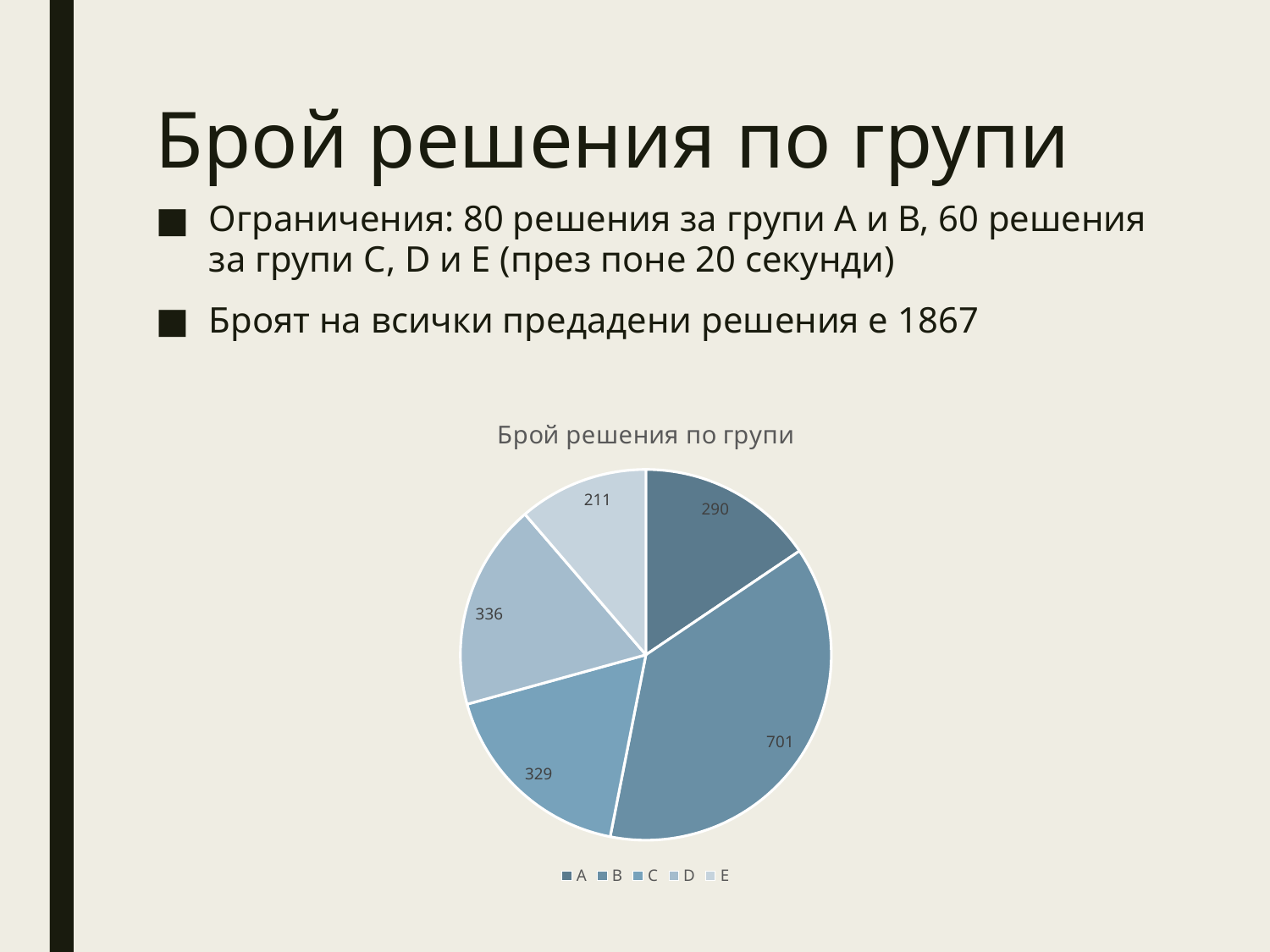
What is the value for group D in the pie chart? 336 What is the difference between the values for group B and group A? 411 What type of chart is shown on the slide? pie chart What is the title of the pie chart? Брой решения по групи Which is larger, the value for group C or group D? D Which group has the smallest slice in the pie chart? E What is the value for group B in the pie chart? 701 What is the value for group E in the pie chart? 211 Which group has the largest slice in the pie chart? B What is the value for group A in the pie chart? 290 What is the total of all slices in the pie chart? 1867 How many groups are shown in the pie chart? 5